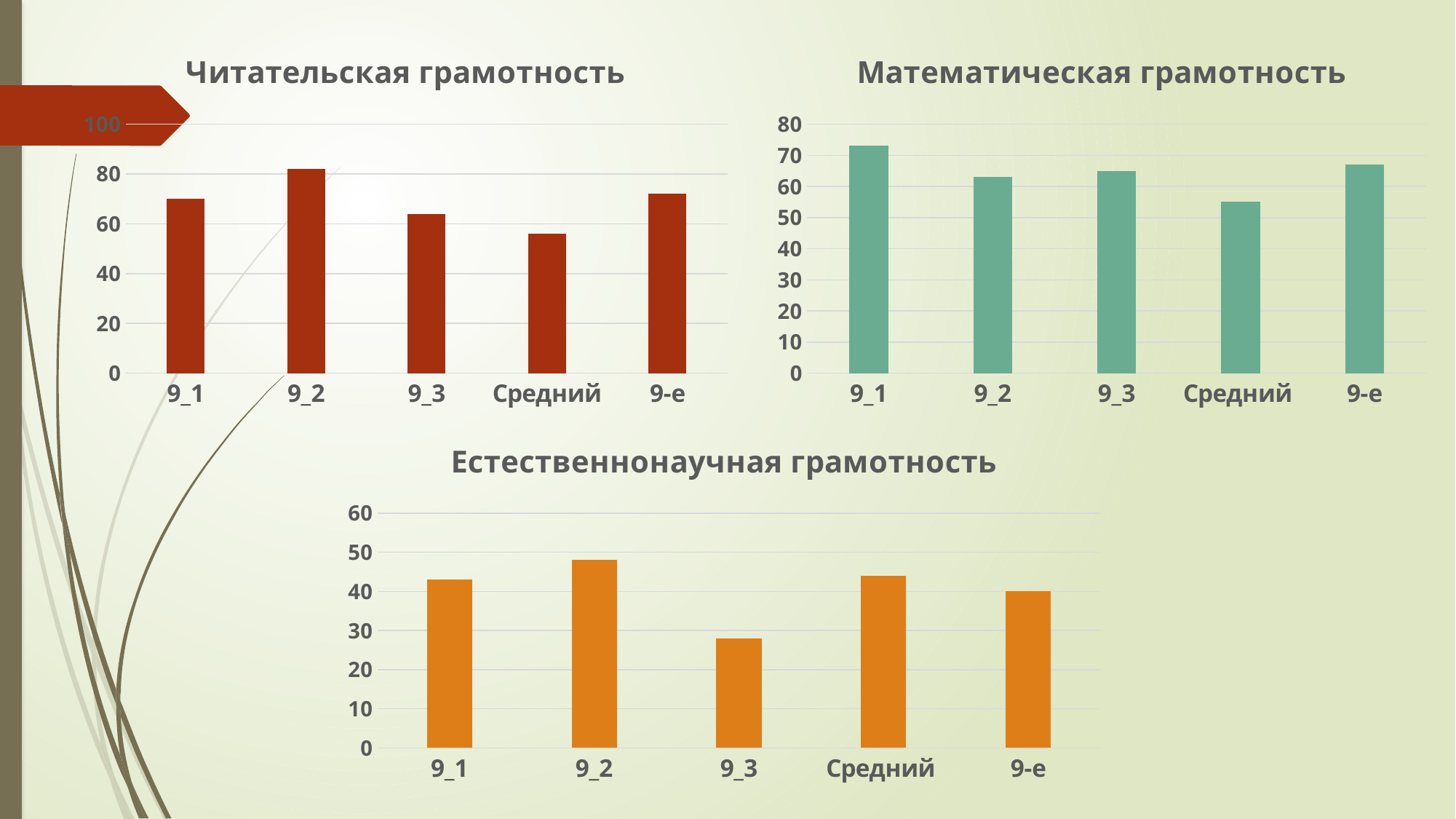
In the chart titled "Математическая грамотность", which is larger, the value for 9_1 or the value for 9_2? 9_1 In the chart titled "Читательская грамотность", is the value for Средний greater or less than 60? less In the chart titled "Читательская грамотность", which category has the lowest bar? Средний In the chart titled "Естественнонаучная грамотность", which category has the lowest bar? 9_3 In the chart titled "Естественнонаучная грамотность", is the value for 9_2 greater or less than 50? less In the chart titled "Читательская грамотность", is the value for 9_3 greater or less than 60? greater In the chart titled "Математическая грамотность", which category has the lowest bar? Средний How many categories are shown on the x axis of the chart titled "Естественнонаучная грамотность"? 5 In the chart titled "Математическая грамотность", which category has the highest bar? 9_1 In the chart titled "Читательская грамотность", which category has the highest bar? 9_2 In the chart titled "Естественнонаучная грамотность", which category has the highest bar? 9_2